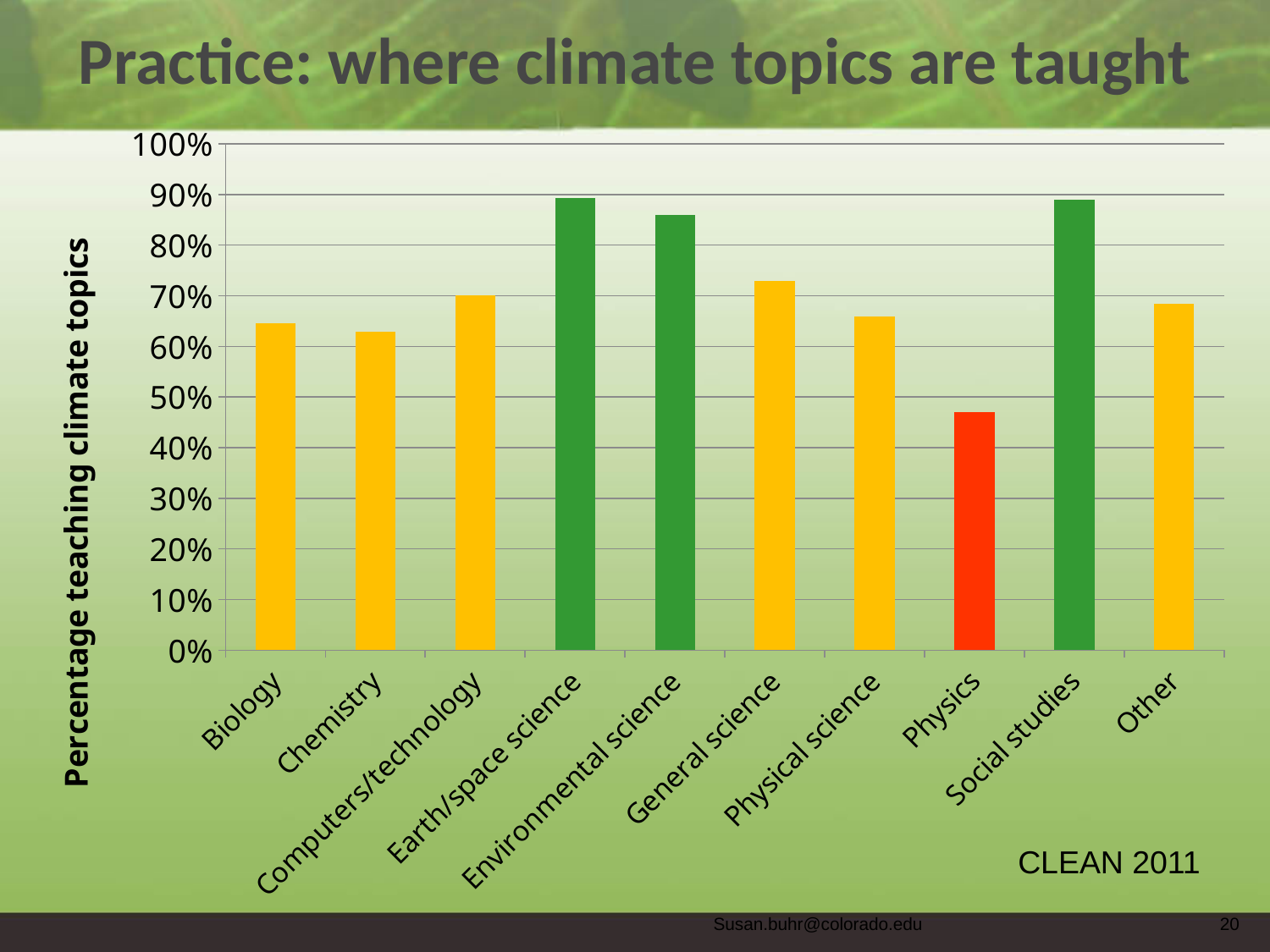
Is the value for Social studies greater or less than 80%? greater Which is larger, the value for Environmental science or the value for Physical science? Environmental science Is the value for Physics greater or less than 50%? less Is the value for Chemistry greater or less than 70%? less What colour is the bar for Physics? red What is the label on the vertical axis? Percentage teaching climate topics What kind of chart is shown on the slide? bar chart Which subject has the lowest percentage teaching climate topics? Physics Which is larger, the value for Physics or the value for Biology? Biology How many subject categories are shown on the x axis? 10